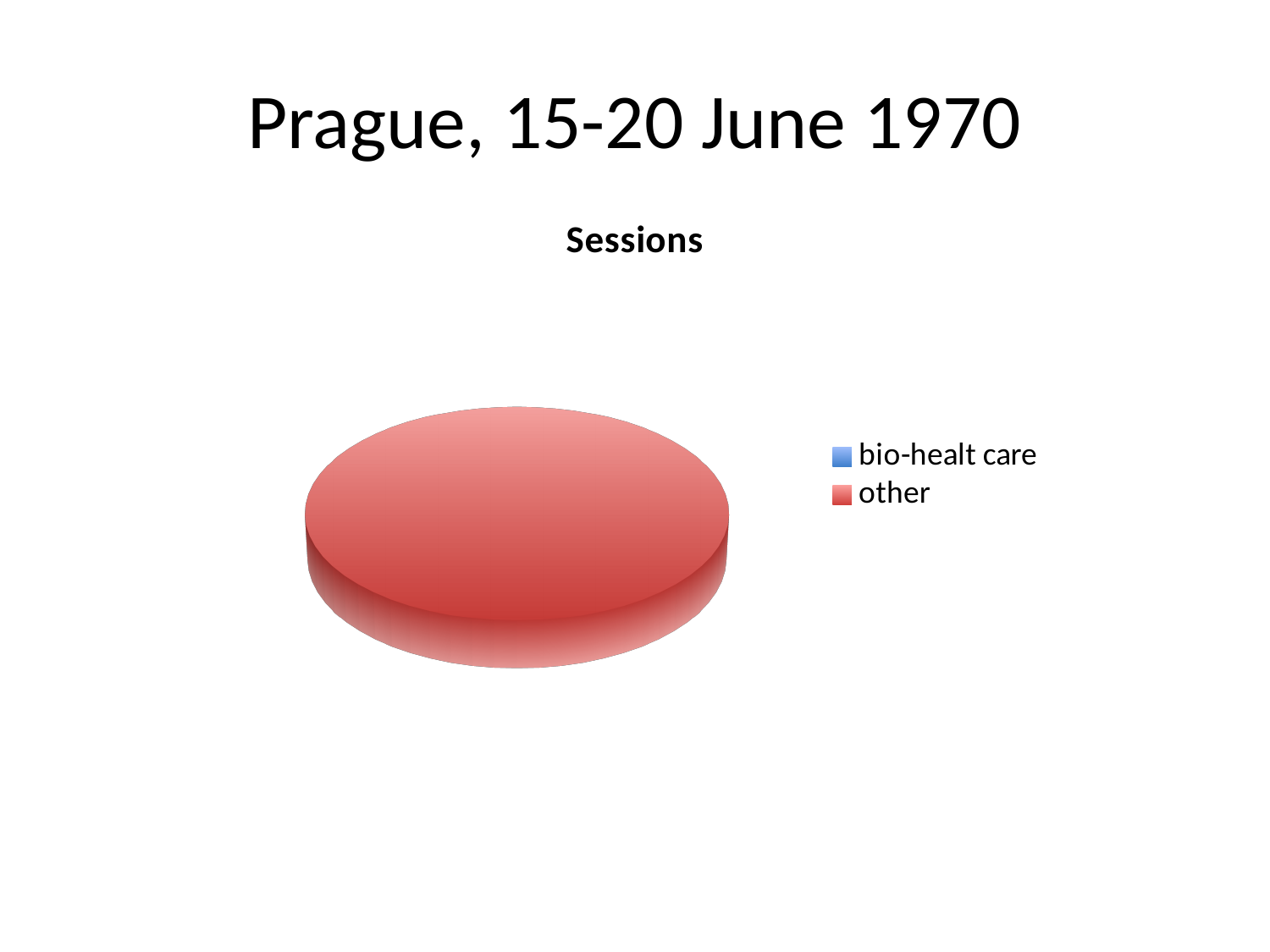
Which is larger, the share for other or the share for bio-healt care? other Which category takes up the largest share of the pie? other What is the title of the chart? Sessions What colour represents the category other in the chart? red Which category takes up the smallest share of the pie? bio-healt care How many categories does the chart's legend list? 2 What kind of chart is shown on the slide? pie chart